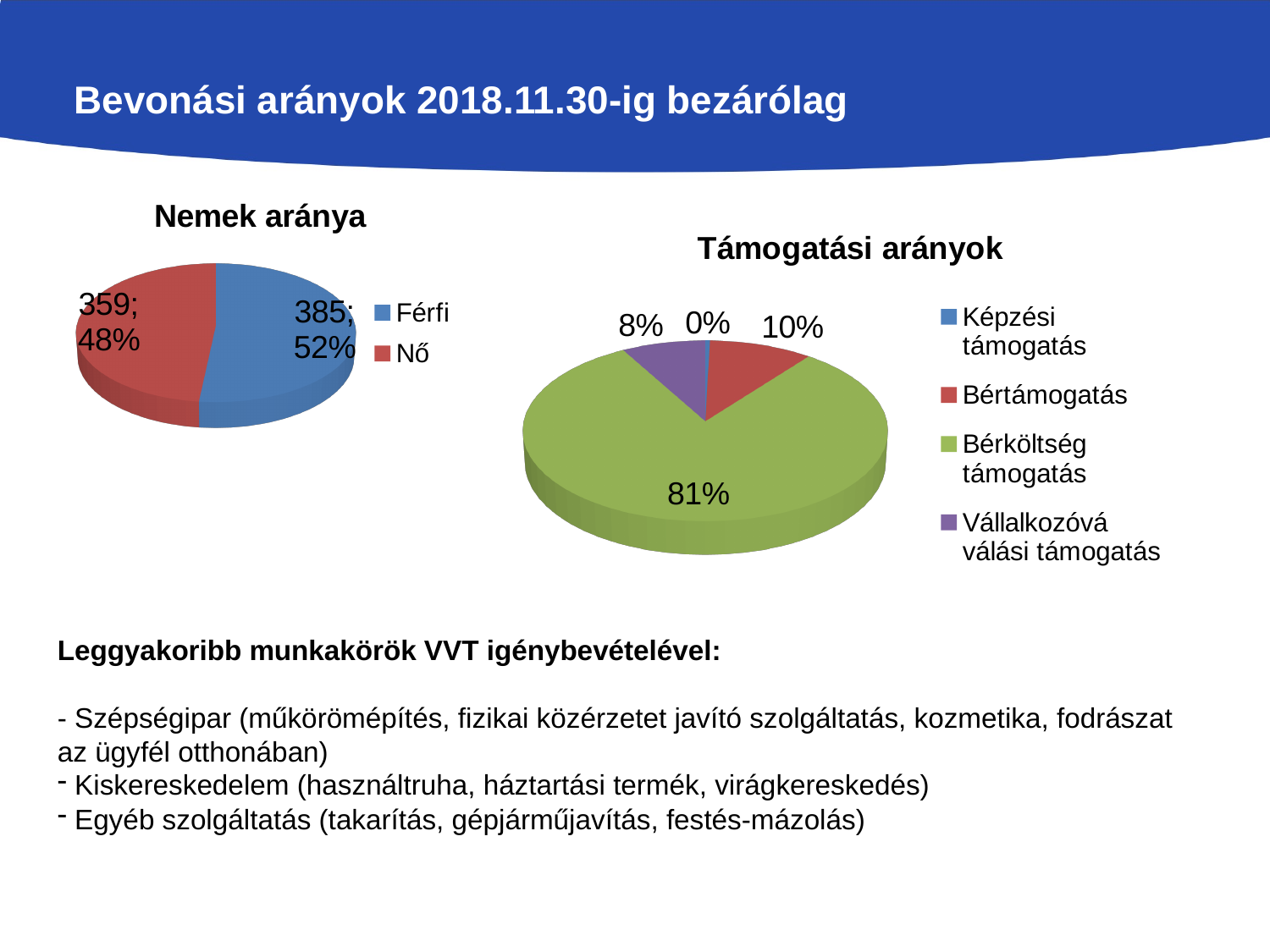
What type of chart is the 'Nemek aránya' chart? Pie chart In the 'Támogatási arányok' chart, which category has the smallest share? Képzési támogatás In the 'Nemek aránya' chart, what is the total of the Férfi and Nő counts? 744 In the 'Nemek aránya' chart, which category has the larger share? Férfi In the 'Támogatási arányok' chart, which is larger: Bértámogatás or Vállalkozóvá válási támogatás? Bértámogatás In the 'Nemek aránya' chart, what value is shown for Nő? 359; 48% In the 'Támogatási arányok' chart, what share does Vállalkozóvá válási támogatás have? 8% In the 'Nemek aránya' chart, what value is shown for Férfi? 385; 52% How many categories does the legend of the 'Támogatási arányok' chart list? 4 In the 'Támogatási arányok' chart, what share does Bérköltség támogatás have? 81% In the 'Nemek aránya' chart, what is the difference between the Férfi and Nő counts? 26 In the 'Támogatási arányok' chart, what share does Bértámogatás have? 10%